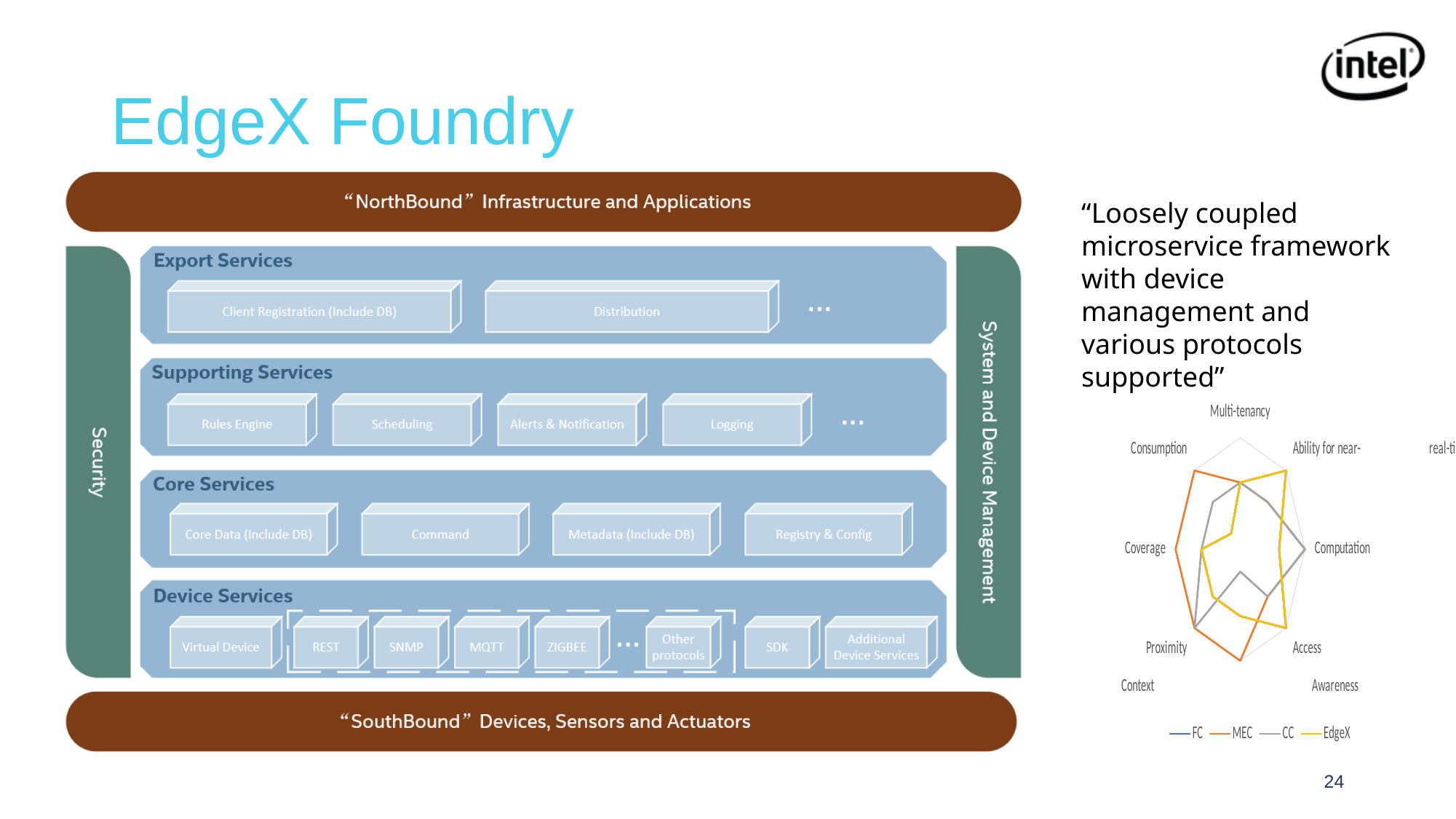
What colour is the EdgeX series in the radar chart? Yellow How many category axes does the radar chart have? 8 Which category is at the top of the radar chart? Multi-tenancy Which series are listed in the legend of the radar chart? FC, MEC, CC, EdgeX How many series does the legend of the radar chart list? 4 What kind of chart is shown on the right side of the slide? Radar chart